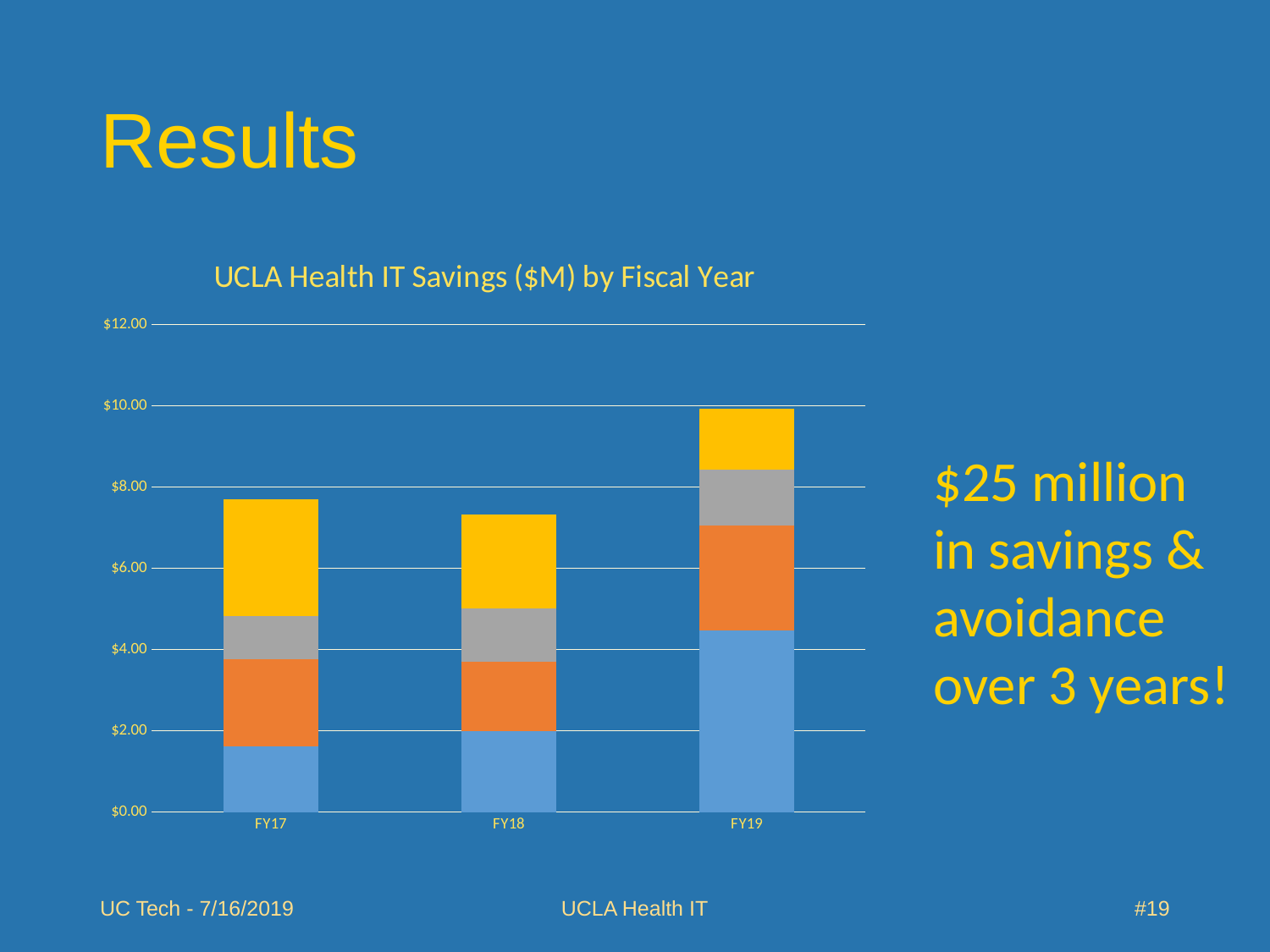
Which has the taller stacked bar, FY17 or FY19? FY19 How many fiscal years are shown on the x axis of the chart? 3 Is the total bar height for FY17 greater or less than $8.00? less Is the total bar height for FY18 greater or less than $6.00? greater What is the title of the chart? UCLA Health IT Savings ($M) by Fiscal Year Is the blue (bottom) segment for FY19 greater or less than $4.00? greater What kind of chart is shown on the slide? Stacked bar chart Which fiscal year has the tallest stacked bar in the chart? FY19 How many coloured segments make up each stacked bar in the chart? 4